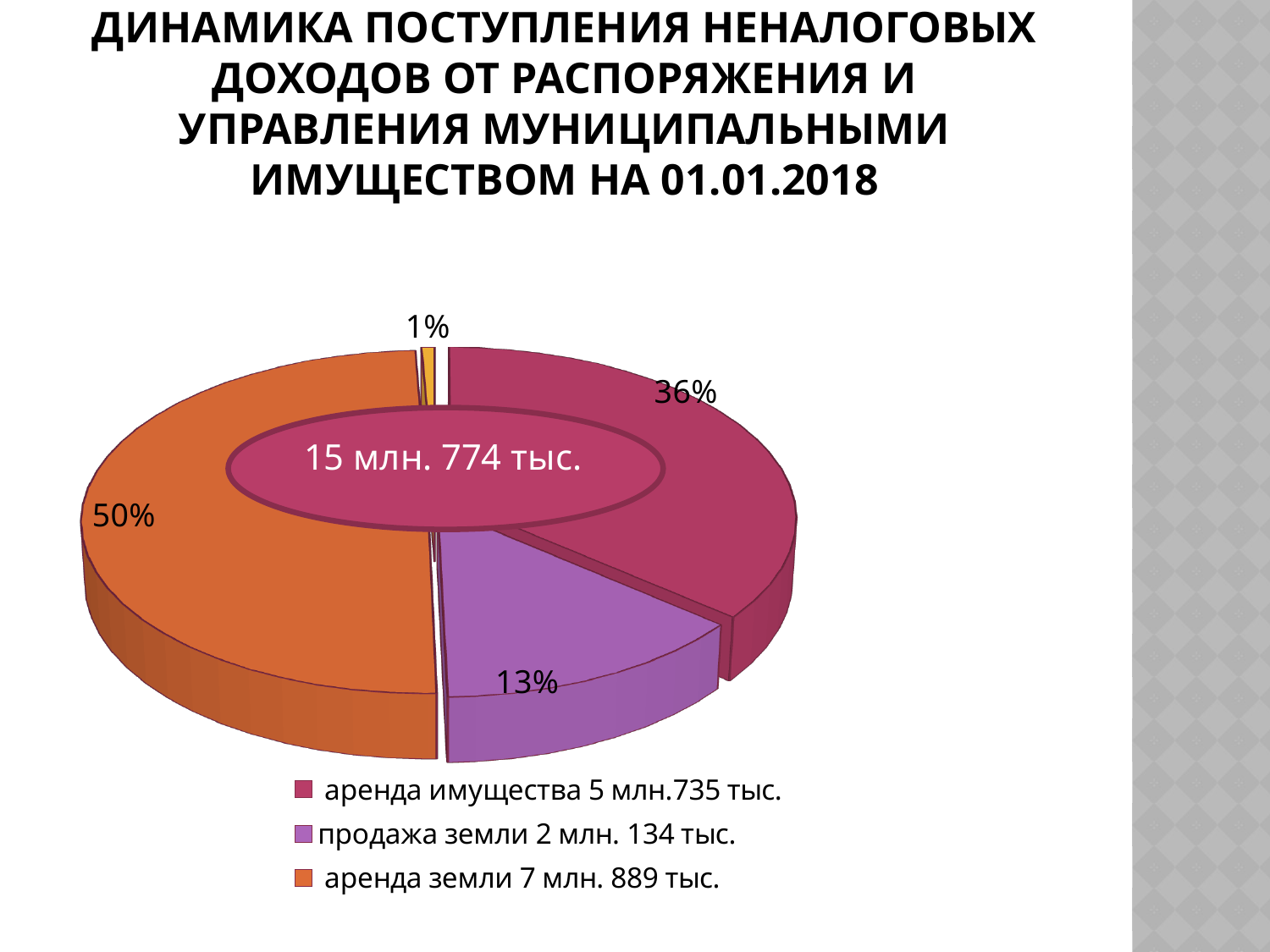
What share of the pie does "аренда имущества" take? 36% What is the smallest percentage label shown on the pie? 1% What total amount is printed in the centre of the pie chart? 15 млн. 774 тыс. What share of the pie does "продажа земли" take? 13% Which of the legend categories has the smallest slice of the pie? продажа земли Which is larger: the share for "аренда имущества" or for "продажа земли"? аренда имущества Which category has the largest slice of the pie? аренда земли How many entries does the legend list? 3 How many slices does the pie chart have? 4 What kind of chart is shown on the slide? pie chart By how many percentage points does the "аренда земли" share exceed the "аренда имущества" share? 14 What share of the pie does "аренда земли" take? 50%